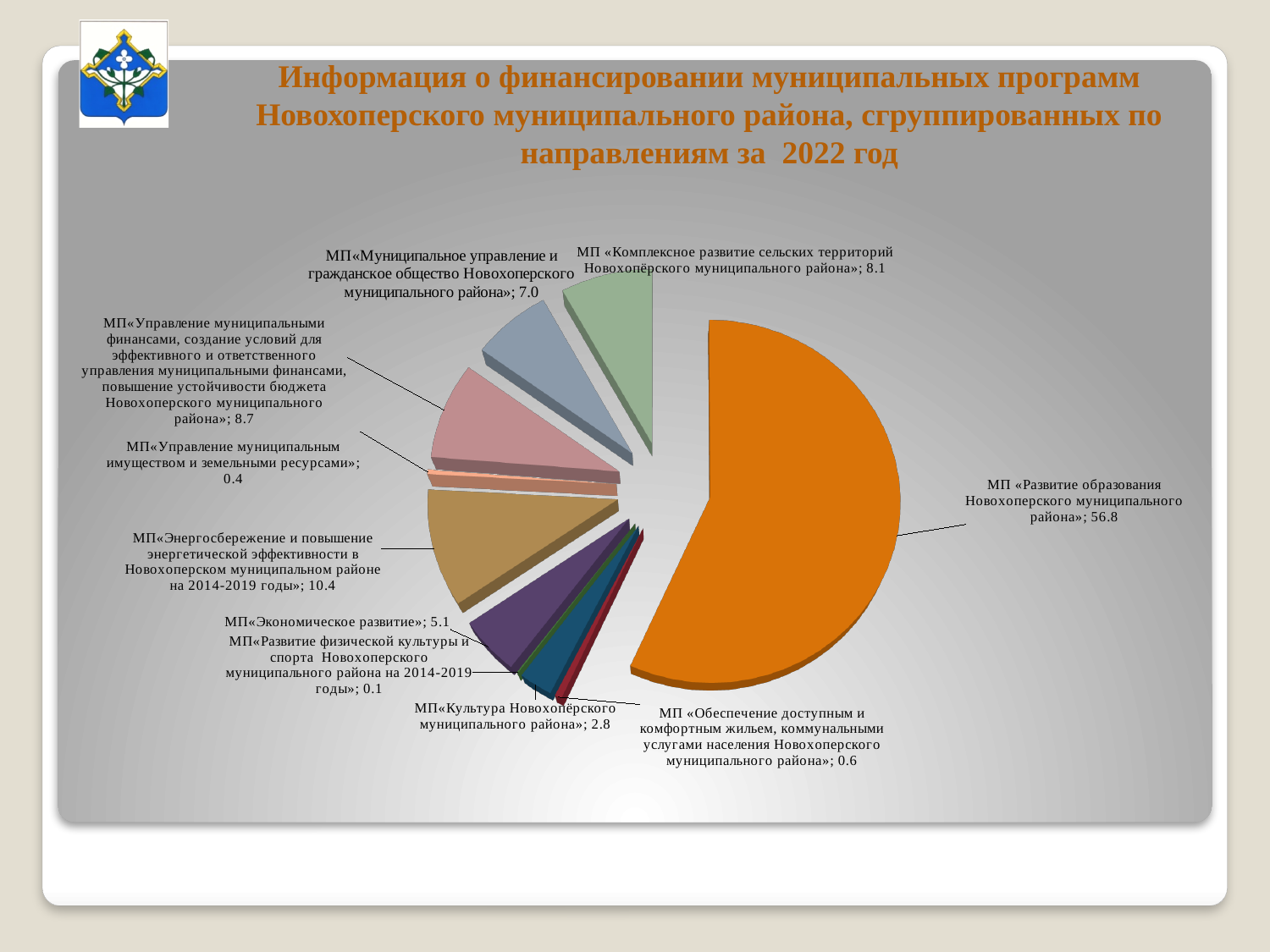
How many slices does the pie chart have? 10 Which is larger: the value for МП«Управление муниципальным имуществом и земельными ресурсами» or the value for МП «Обеспечение доступным и комфортным жильем, коммунальными услугами населения Новохоперского муниципального района»? МП «Обеспечение доступным и комфортным жильем, коммунальными услугами населения Новохоперского муниципального района» What value is shown for МП«Энергосбережение и повышение энергетической эффективности в Новохоперском муниципальном районе на 2014-2019 годы»? 10.4 What value is shown for МП «Развитие образования Новохоперского муниципального района»? 56.8 Which programme has the smallest slice of the pie chart? МП«Развитие физической культуры и спорта Новохоперского муниципального района на 2014-2019 годы» What year does the chart title say the financing information is for? 2022 What value is shown for МП«Культура Новохопёрского муниципального района»? 2.8 What kind of chart is shown on the slide? Pie chart Which programme has the largest slice of the pie chart? МП «Развитие образования Новохоперского муниципального района» What value is shown for МП«Экономическое развитие»? 5.1 What is the difference between the values for МП«Управление муниципальными финансами...» (8.7) and МП«Муниципальное управление и гражданское общество...» (7.0)? 1.7 What value is shown for МП «Комплексное развитие сельских территорий Новохопёрского муниципального района»? 8.1